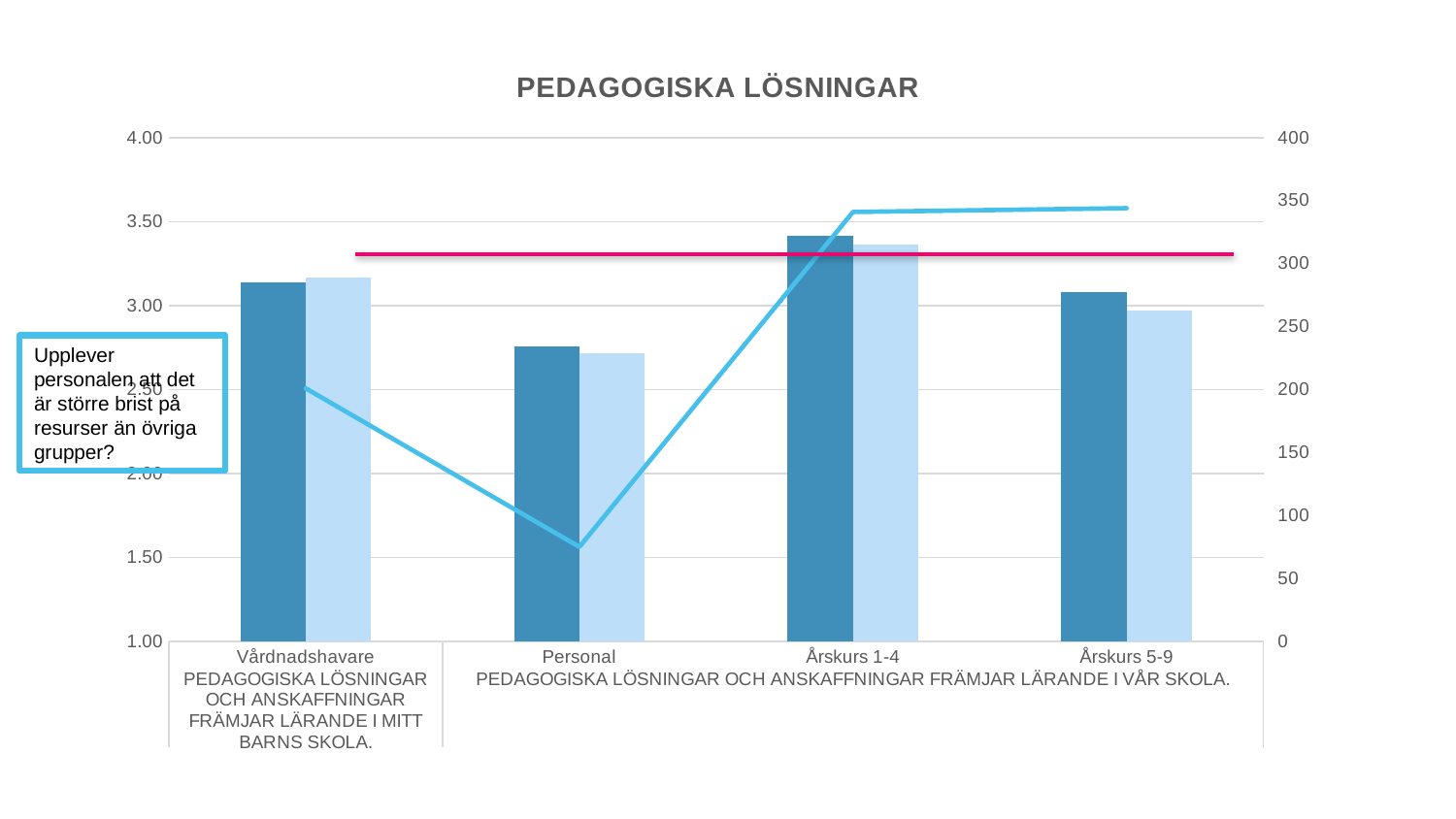
Does the light blue line rise or fall from Personal to Årskurs 1-4? rise What kind of chart is shown on the slide? Bar chart combined with a line Which category has the tallest dark blue bar? Årskurs 1-4 Which category has the lowest point on the light blue line? Personal What is the title of the chart? PEDAGOGISKA LÖSNINGAR Is the light blue line value for Årskurs 1-4 greater or less than 300 on the right axis? greater Is the light blue line value for Personal greater or less than 100 on the right axis? less Which has the taller dark blue bar, Personal or Årskurs 5-9? Årskurs 5-9 How many categories are shown on the x axis of the chart? 4 Is the dark blue bar for Årskurs 1-4 greater or less than 3.00 on the left axis? greater Which category has the shortest dark blue bar? Personal